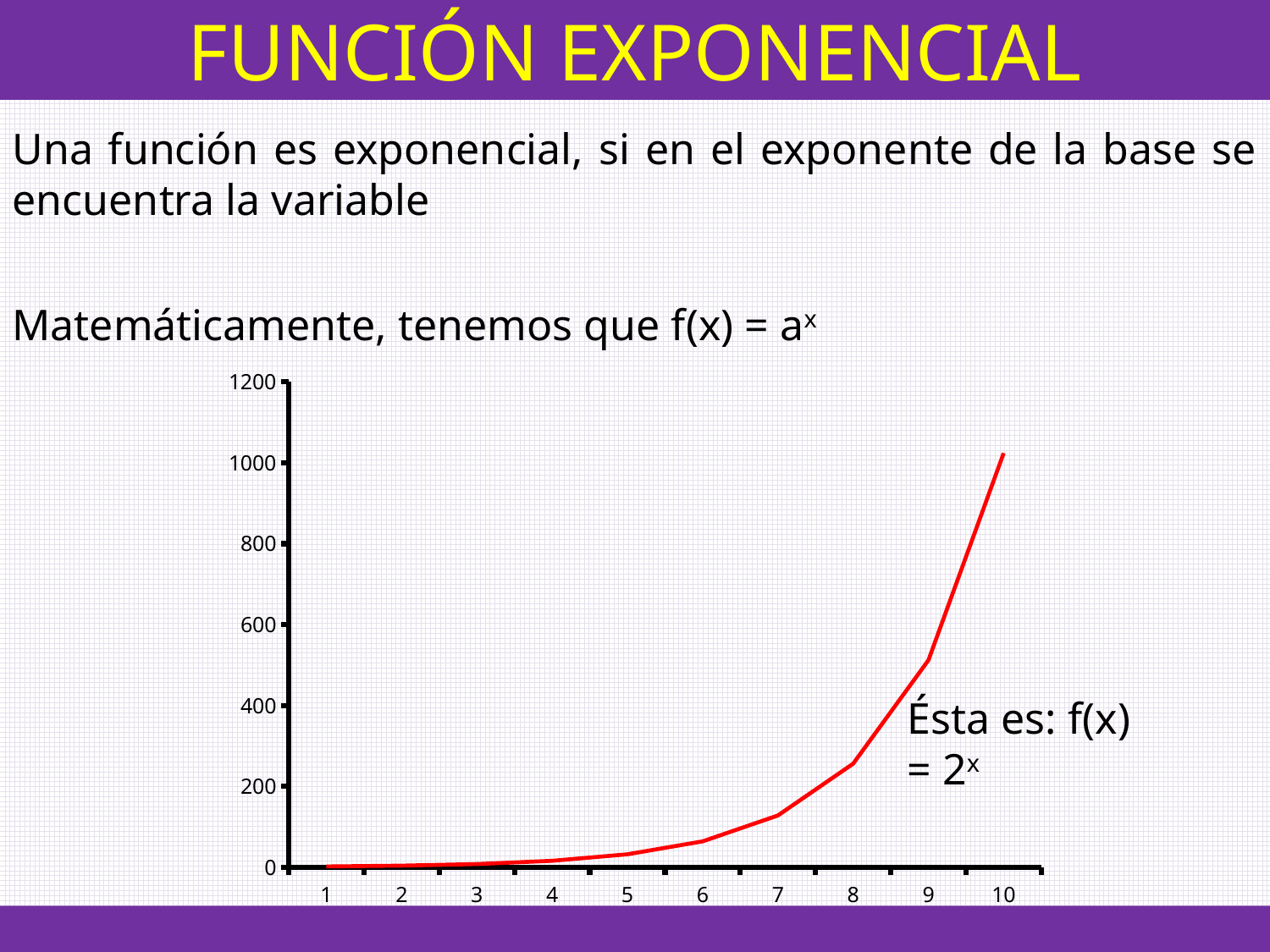
Do the values on the chart rise or fall as x increases from 1 to 10? rise How many x-axis points are plotted on the chart? 10 Is the value at x = 7 greater or less than 200? less What colour is the plotted line on the chart? red Is the value at x = 9 greater or less than 600? less What kind of chart is shown on the slide? line chart Is the value at x = 10 greater or less than 800? greater At which x value is the curve at its lowest point? 1 What function does the annotation on the chart say the curve represents? f(x) = 2^x Which is larger, the value at x = 9 or the value at x = 8? x = 9 At which x value does the curve reach its highest point? 10